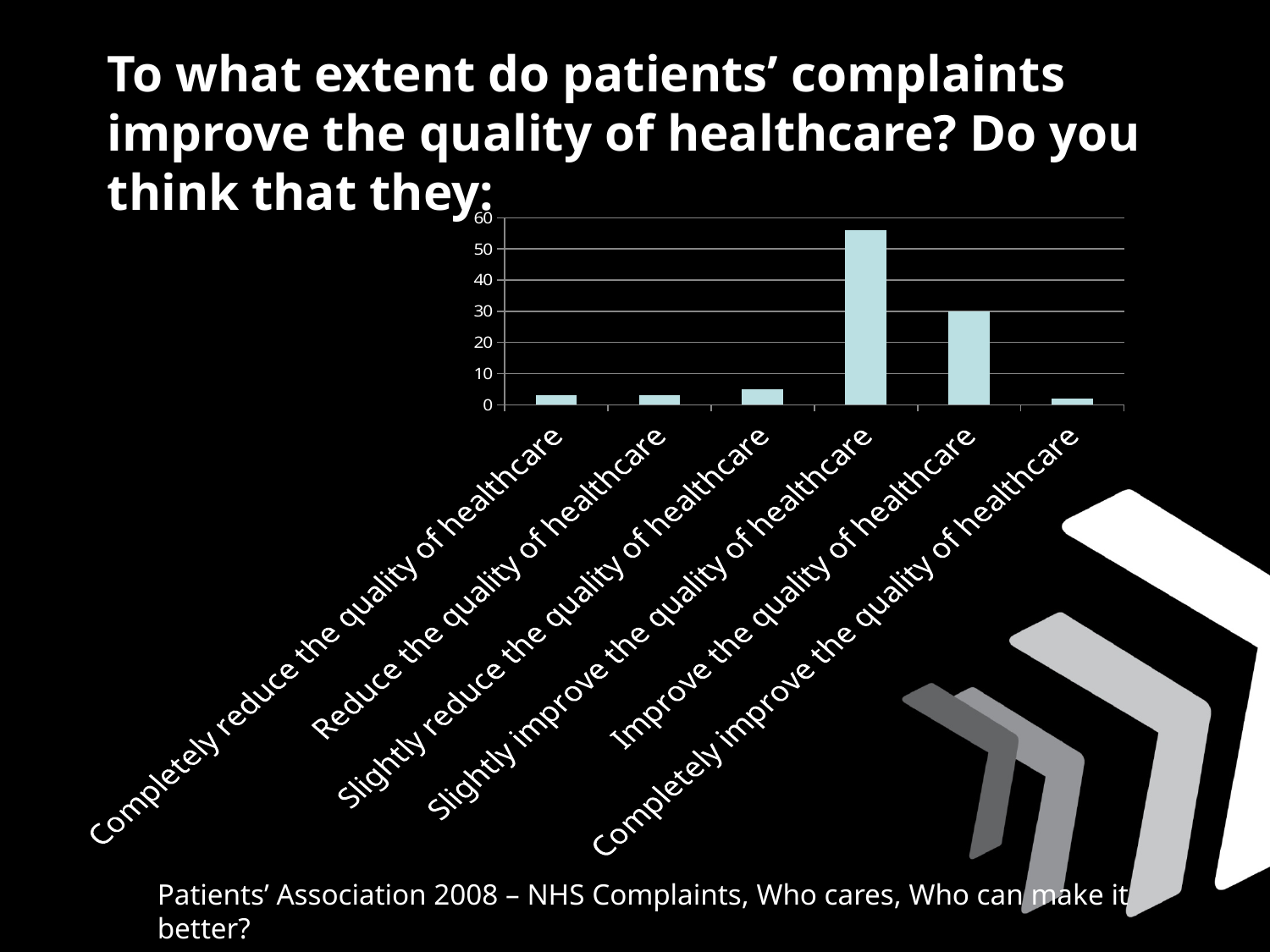
Which category has the highest bar in the chart? Slightly improve the quality of healthcare Is the value for 'Slightly improve the quality of healthcare' greater or less than 50? greater What is the highest value shown on the chart's vertical axis? 60 How many categories are shown on the x axis of the chart? 6 Is the value for 'Improve the quality of healthcare' greater or less than 20? greater Which is larger: the value for 'Completely improve the quality of healthcare' or the value for 'Improve the quality of healthcare'? Improve the quality of healthcare Which is larger: the value for 'Slightly improve the quality of healthcare' or the value for 'Improve the quality of healthcare'? Slightly improve the quality of healthcare Is the value for 'Improve the quality of healthcare' greater or less than 40? less What question does the slide title ask about patients' complaints? To what extent do patients' complaints improve the quality of healthcare? Do you think that they: What kind of chart is shown on the slide? bar chart